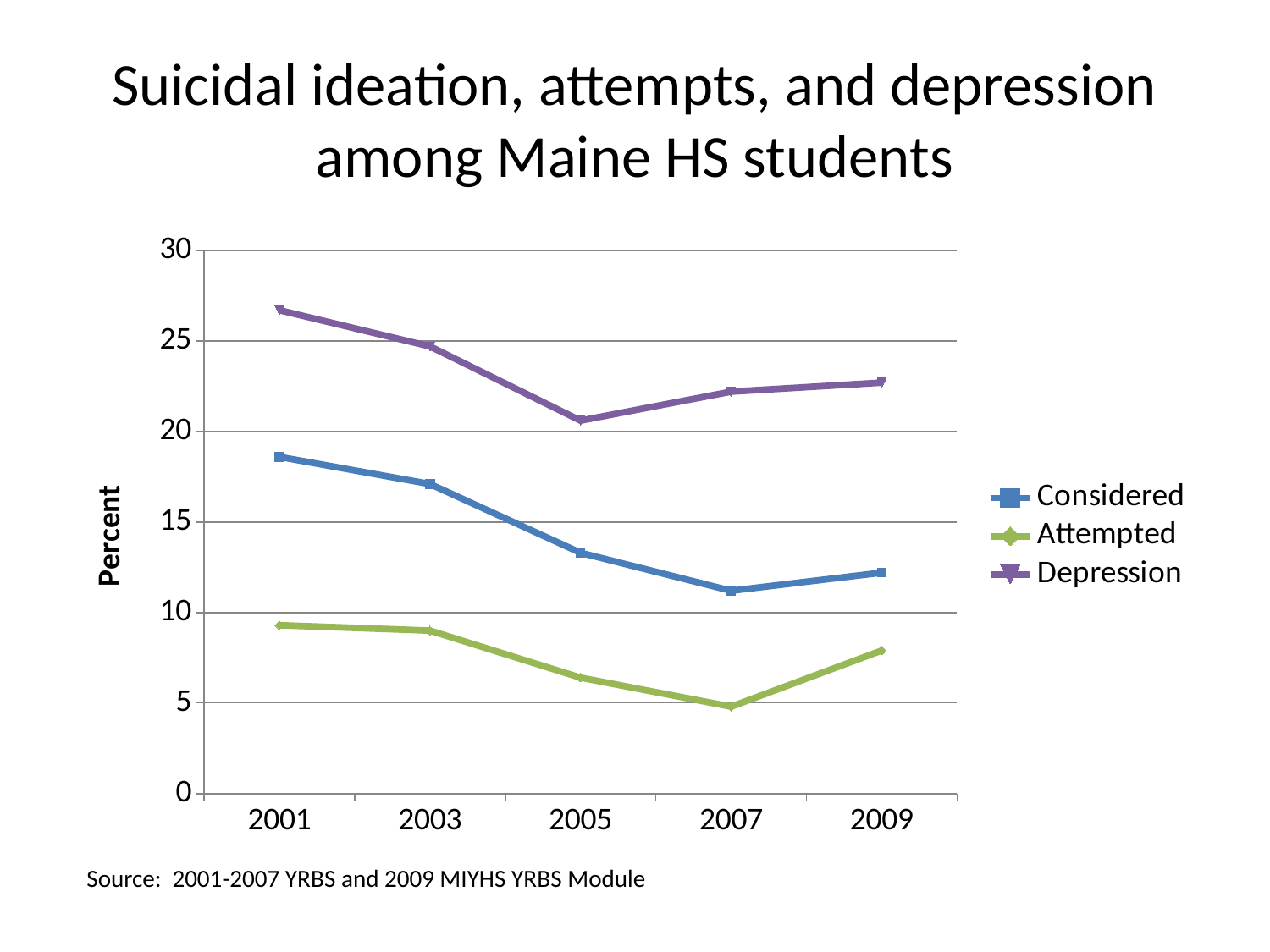
Is the value for Attempted in 2009 greater or less than 10? less What kind of chart is shown on the slide? line chart How many years are plotted along the x axis? 5 In which year is the Considered series at its lowest? 2007 Which is larger, the Considered value in 2001 or the Considered value in 2009? 2001 Is the value for Considered in 2001 greater or less than 15? greater In which year is the Depression series at its highest? 2001 Is the value for Depression in 2001 greater or less than 25? greater Does the Considered series rise or fall from 2001 to 2007? fall How many series does the legend list? 3 What is the label on the y axis? Percent Which series has the highest values across all years? Depression